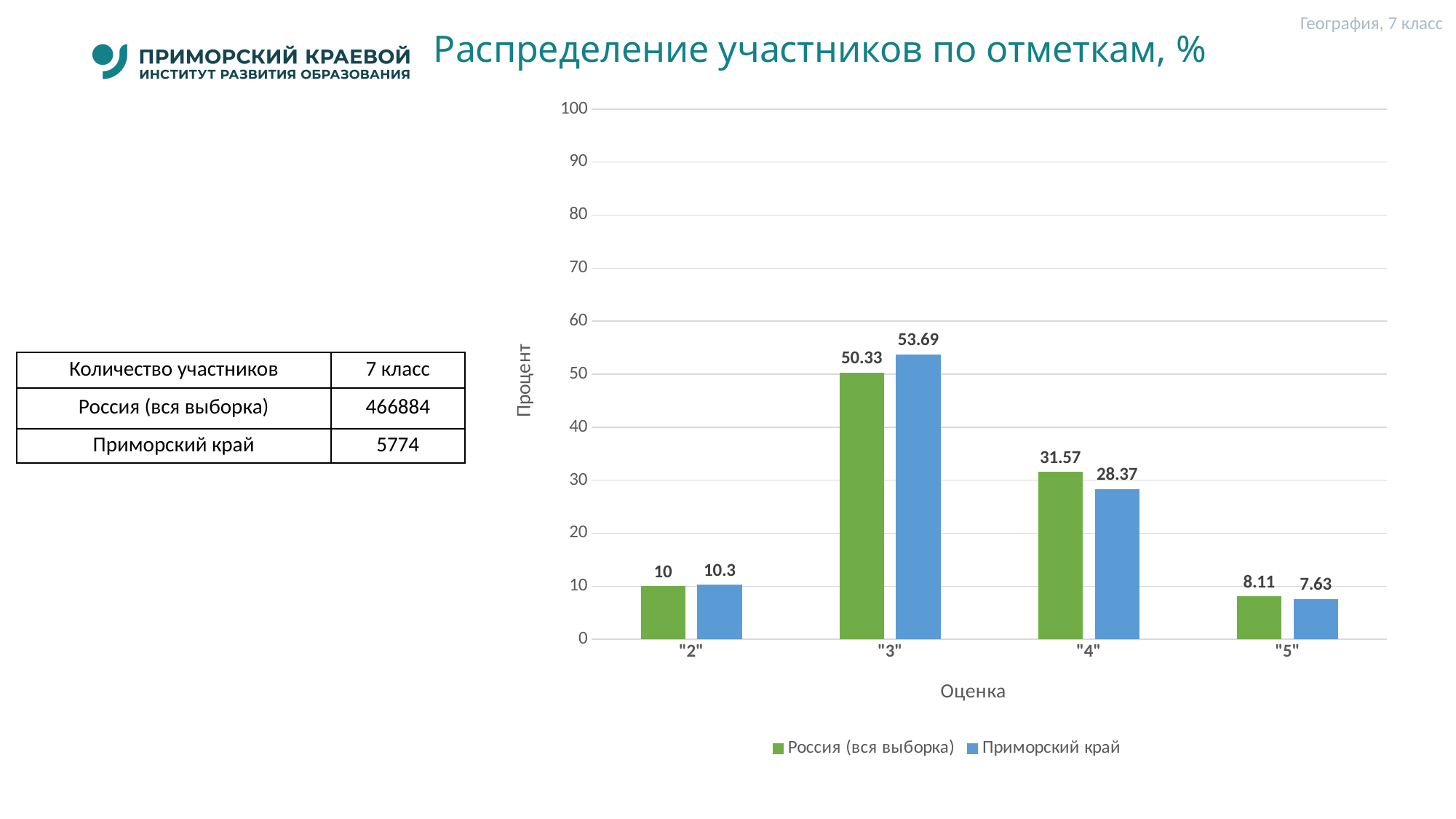
What is the value for Приморский край at grade "2"? 10.3 How many grade categories are shown on the x axis? 4 Is the value for Приморский край at grade "4" greater or less than 30? less What is the difference between Приморский край and Россия (вся выборка) at grade "3"? 3.36 Which grade has the lowest value for Приморский край? "5" What is the label of the y axis? Процент What is the value for Россия (вся выборка) at grade "4"? 31.57 What is the value for Приморский край at grade "3"? 53.69 At grade "4", which series has the larger value, Россия (вся выборка) or Приморский край? Россия (вся выборка) What kind of chart is shown on the slide? bar chart How many series does the legend list? 2 Which grade has the highest value for Россия (вся выборка)? "3"